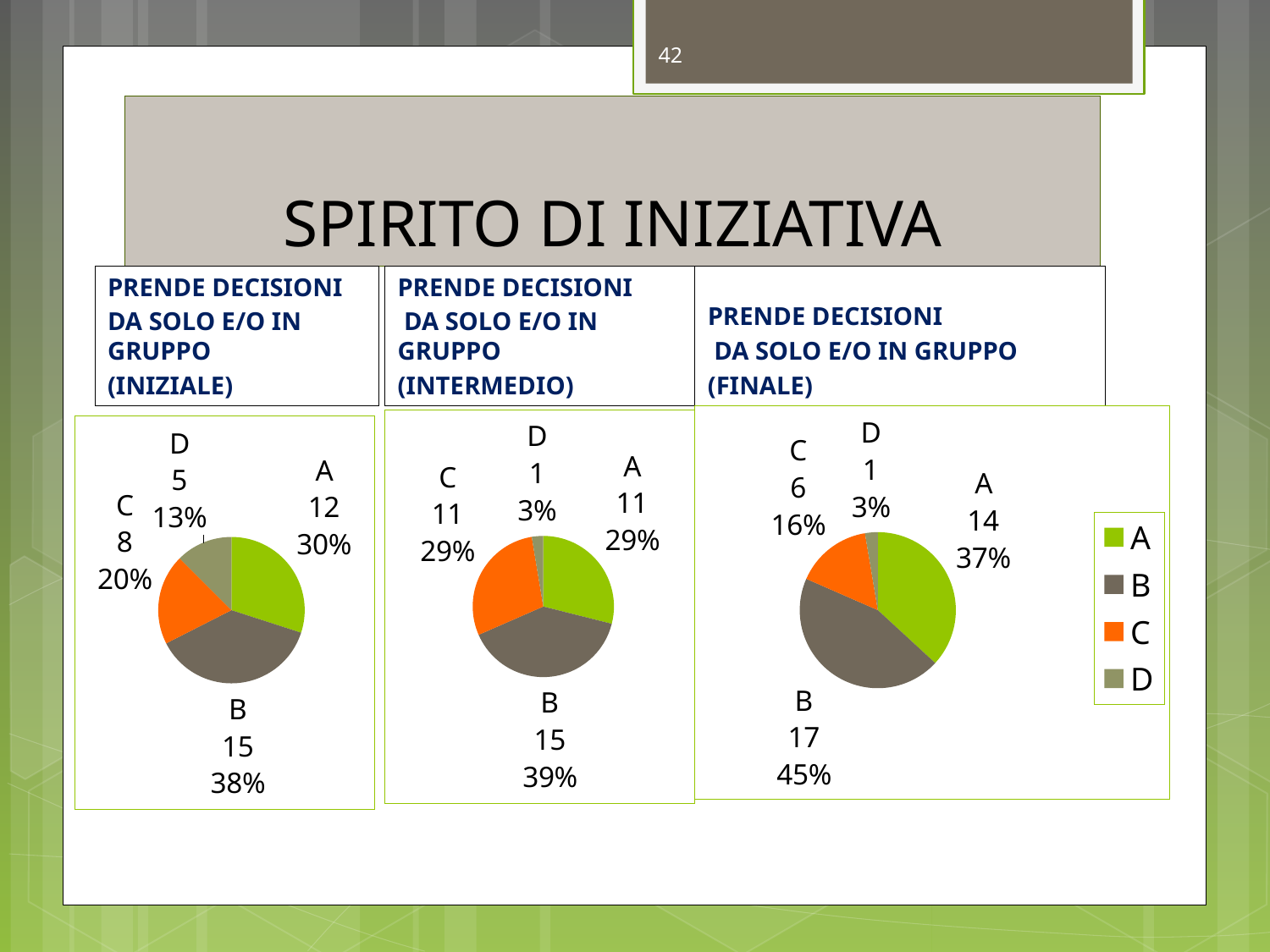
In the FINALE pie chart, what is the value for category A? 14 In the INTERMEDIO pie chart, which category has the largest value? B In the FINALE pie chart, what share of the pie does category C represent? 16% In the INIZIALE pie chart, what share of the pie does category C represent? 20% In the INTERMEDIO pie chart, what share of the pie does category B represent? 39% In the FINALE pie chart, which is larger, the value for C or the value for D? C What type of chart is used for the FINALE data? Pie chart How many categories does the INIZIALE pie chart show? 4 In the FINALE pie chart, what is the difference between the values for B and A? 3 In the INTERMEDIO pie chart, what is the value for category D? 1 In the INIZIALE pie chart, what is the value for category B? 15 In the INIZIALE pie chart, which category has the smallest value? D